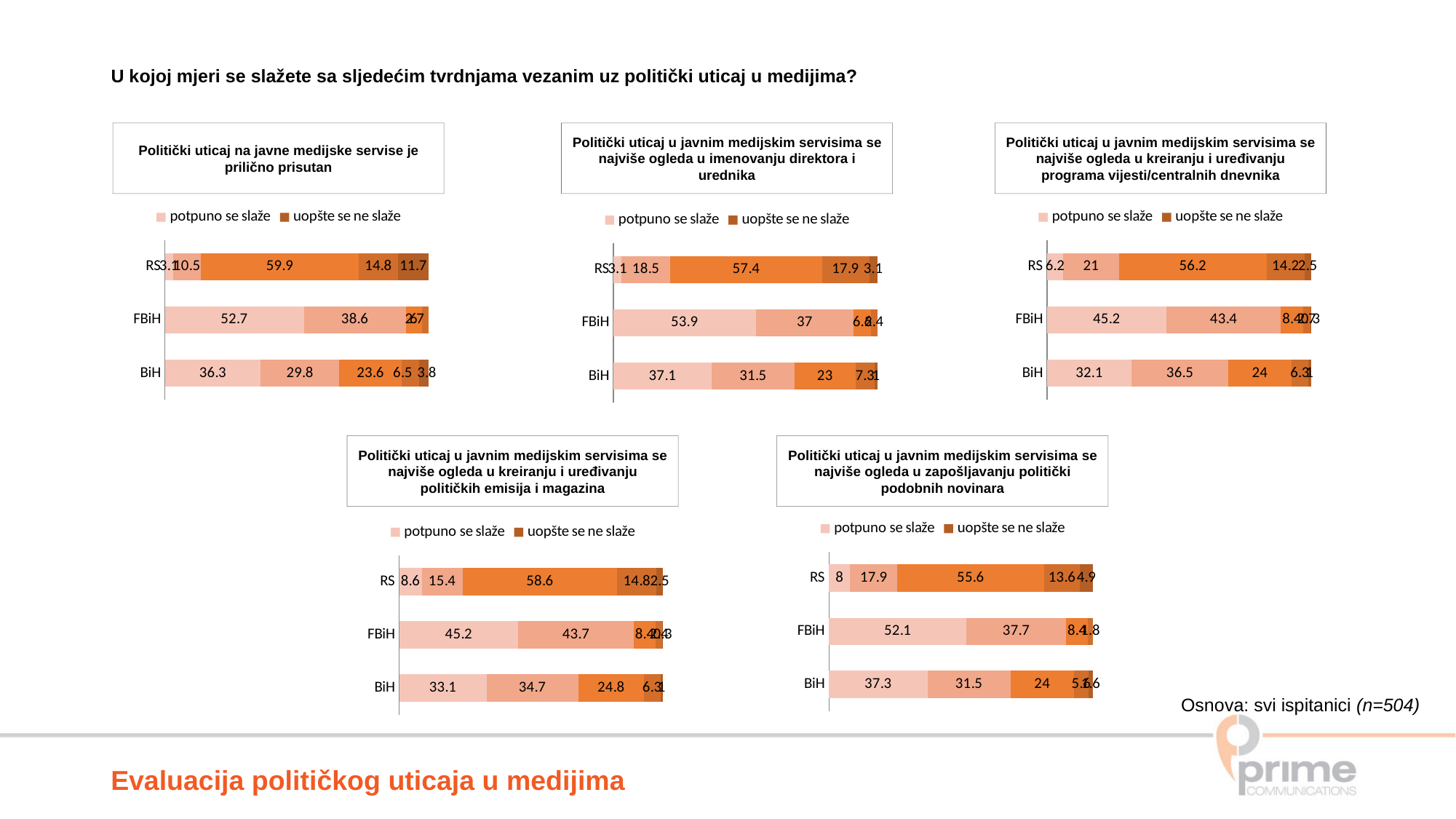
In the chart titled 'Politički uticaj na javne medijske servise je prilično prisutan', what is the difference between the 'potpuno se slaže' values for FBiH and BiH? 16.4 In the chart titled 'Politički uticaj u javnim medijskim servisima se najviše ogleda u kreiranju i uređivanju političkih emisija i magazina', what is the value of the largest segment for RS? 58.6 In the chart titled 'Politički uticaj u javnim medijskim servisima se najviše ogleda u zapošljavanju politički podobnih novinara', what is the 'potpuno se slaže' value for FBiH? 52.1 What kind of chart is used on this slide for each of the five statements? bar chart How many entries does the legend of each chart list? 2 In the chart titled 'Politički uticaj u javnim medijskim servisima se najviše ogleda u imenovanju direktora i urednika', is the 'potpuno se slaže' value larger for FBiH or for BiH? FBiH In the chart titled 'Politički uticaj u javnim medijskim servisima se najviše ogleda u kreiranju i uređivanju programa vijesti/centralnih dnevnika', what is the 'potpuno se slaže' value for RS? 6.2 In the chart titled 'Politički uticaj u javnim medijskim servisima se najviše ogleda u imenovanju direktora i urednika', what is the 'potpuno se slaže' value for BiH? 37.1 In the chart titled 'Politički uticaj na javne medijske servise je prilično prisutan', which category has the highest 'potpuno se slaže' value? FBiH How many categories are shown on the y axis of each chart on the slide? 3 In the chart titled 'Politički uticaj na javne medijske servise je prilično prisutan', what is the value of the 'potpuno se slaže' segment for FBiH? 52.7 In the chart titled 'Politički uticaj na javne medijske servise je prilično prisutan', what is the value of the largest segment for RS? 59.9